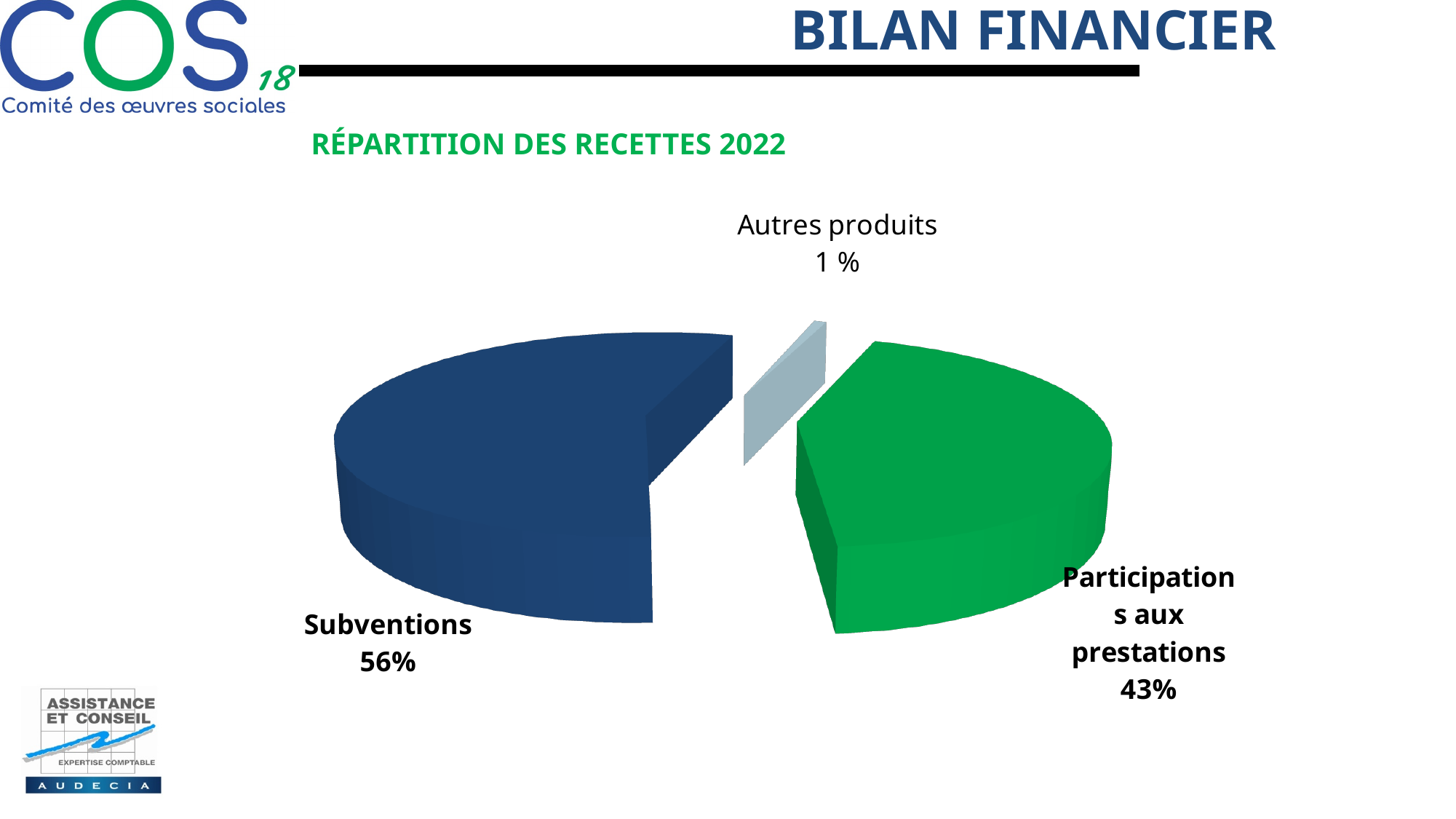
What colour is the Subventions slice? Dark blue Which is larger, Subventions or Participations aux prestations? Subventions How many categories are shown in the pie chart? 3 What share of the pie does Subventions represent? 56% Which category has the smallest slice of the pie? Autres produits Is the share for Participations aux prestations greater or less than 50%? less Which category has the largest slice of the pie? Subventions What share of the pie does Participations aux prestations represent? 43% What kind of chart is shown on the slide? Pie chart What is the title of the chart? RÉPARTITION DES RECETTES 2022 What share of the pie does Autres produits represent? 1 % What is the difference in percentage points between Subventions and Participations aux prestations? 13